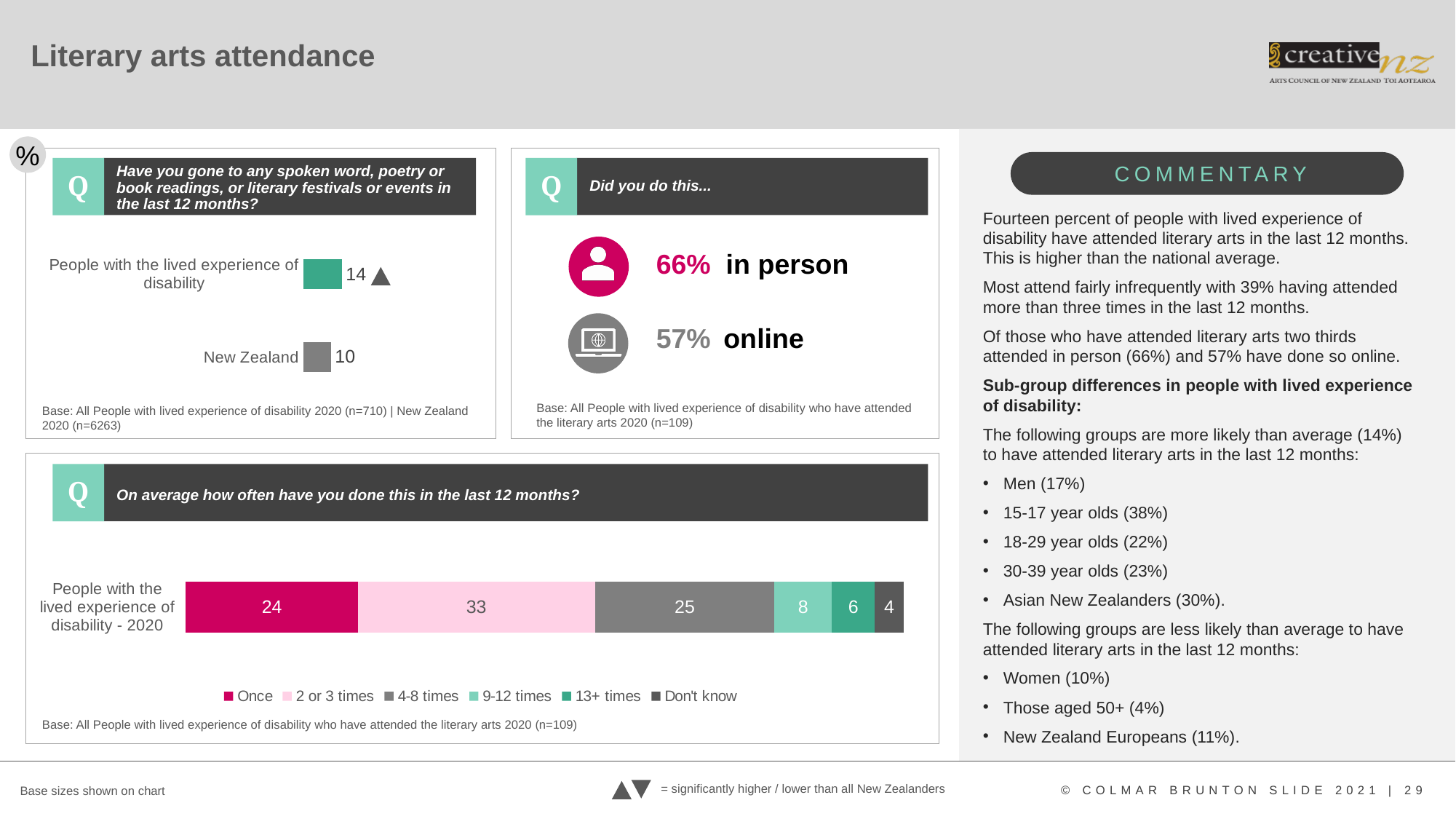
In the bottom chart on how often people have done this in the last 12 months, how many series does the legend list? 6 In the bottom chart on how often people have done this in the last 12 months, which segment is the smallest? Don't know In the top-left chart on attendance in the last 12 months, what is the value for People with the lived experience of disability? 14 In the top-left chart on attendance in the last 12 months, what is the value for New Zealand? 10 In the bottom chart on how often people have done this in the last 12 months, what is the total of the stacked bar? 100 In the top-left chart on attendance in the last 12 months, what is the difference between the value for People with the lived experience of disability and the value for New Zealand? 4 In the top-left chart on attendance in the last 12 months, how many categories are shown? 2 In the top-left chart on attendance in the last 12 months, which category has the higher value? People with the lived experience of disability In the bottom chart on how often people have done this in the last 12 months, what is the value for 2 or 3 times? 33 What kind of chart is the bottom chart on how often people have done this in the last 12 months? Stacked bar chart In the bottom chart on how often people have done this in the last 12 months, what is the value for 13+ times? 6 In the bottom chart on how often people have done this in the last 12 months, which segment is the largest? 2 or 3 times